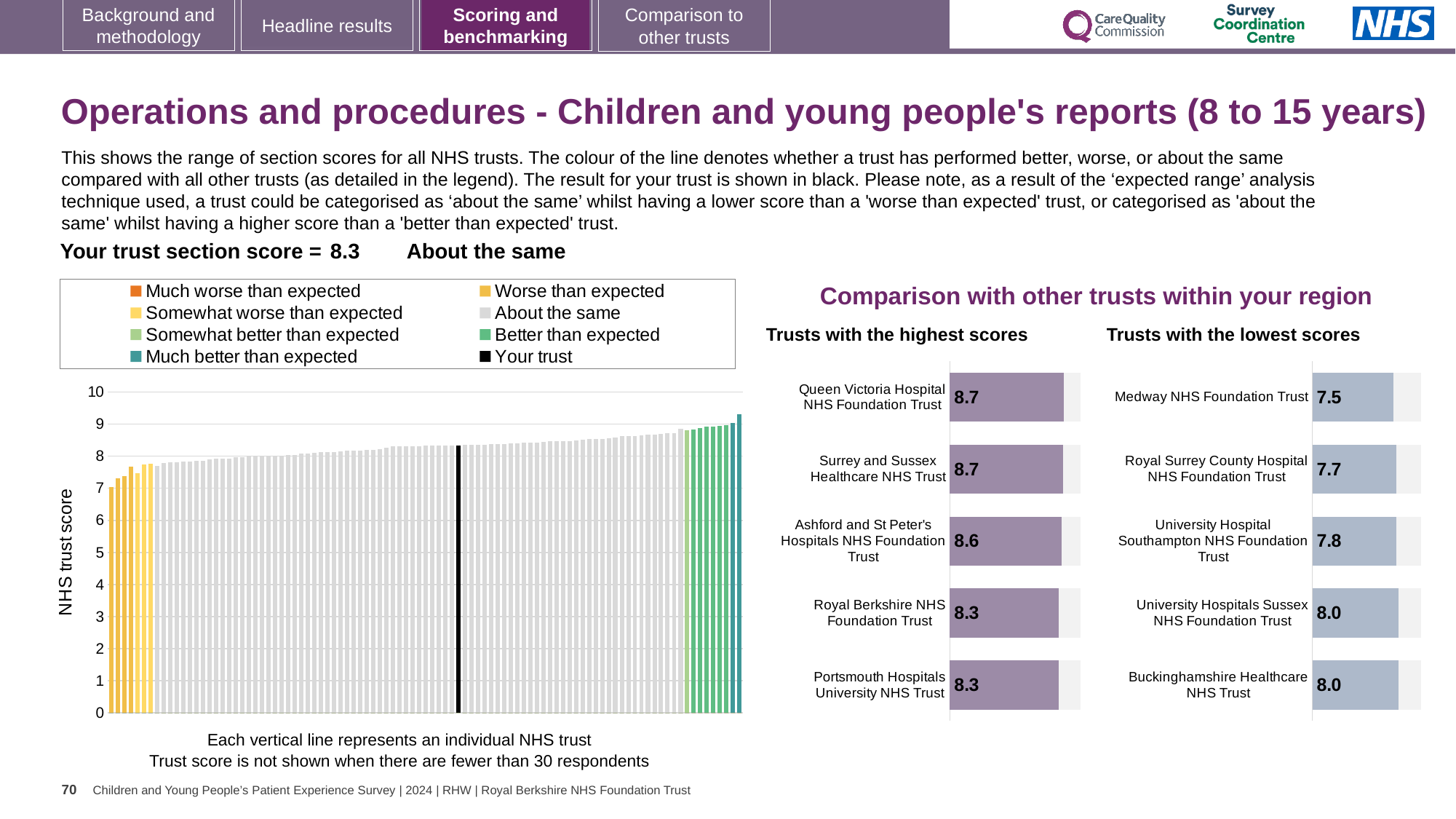
In the large chart on the left, is the value for the leftmost trust greater or less than 8? less In the large chart on the left, do the trust scores rise or fall from left to right? Rise In the 'Trusts with the lowest scores' chart, which trust has the lowest score? Medway NHS Foundation Trust In the 'Trusts with the lowest scores' chart, what is the score for University Hospital Southampton NHS Foundation Trust? 7.8 What kind of chart is the large chart on the left showing NHS trust scores? Bar chart In the large chart on the left, what colour is the bar for your trust? Black In the 'Trusts with the lowest scores' chart, what is the difference between the scores of Buckinghamshire Healthcare NHS Trust and Medway NHS Foundation Trust? 0.5 In the 'Trusts with the lowest scores' chart, what is the score for Medway NHS Foundation Trust? 7.5 In the 'Trusts with the highest scores' chart, what is the score for Ashford and St Peter's Hospitals NHS Foundation Trust? 8.6 How many trusts are shown in the 'Trusts with the highest scores' chart? 5 In the 'Trusts with the lowest scores' chart, which has the higher score: Royal Surrey County Hospital NHS Foundation Trust or University Hospitals Sussex NHS Foundation Trust? University Hospitals Sussex NHS Foundation Trust How many entries does the legend above the large chart on the left list? 8